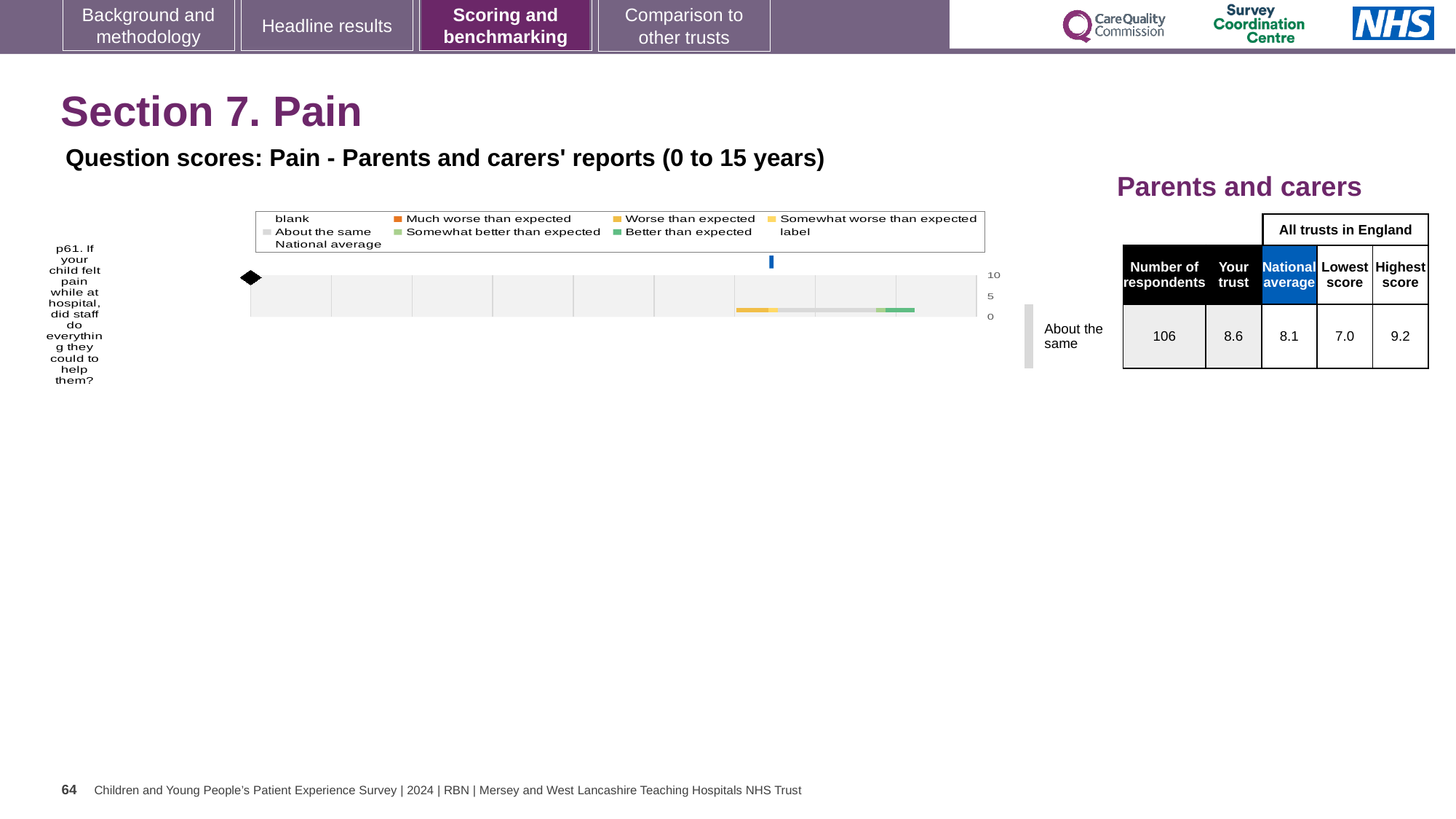
How many entries does the chart legend list? 9 How many survey questions are plotted in the chart? 1 What is the highest value shown on the chart's score axis? 10 In the table beside the chart, what is the highest score among all trusts in England for question p61? 9.2 What kind of chart is shown on the slide? bar chart In the table beside the chart, what is the national average score for question p61? 8.1 For question p61, what is the difference between the 'Your trust' score and the national average? 0.5 In the table beside the chart, what is the 'Your trust' score for question p61? 8.6 In the table beside the chart, how many respondents answered question p61? 106 In the table beside the chart, what is the lowest score among all trusts in England for question p61? 7.0 For question p61, which is larger: the 'Your trust' score or the national average? Your trust What colour does the legend use for 'Better than expected'? green